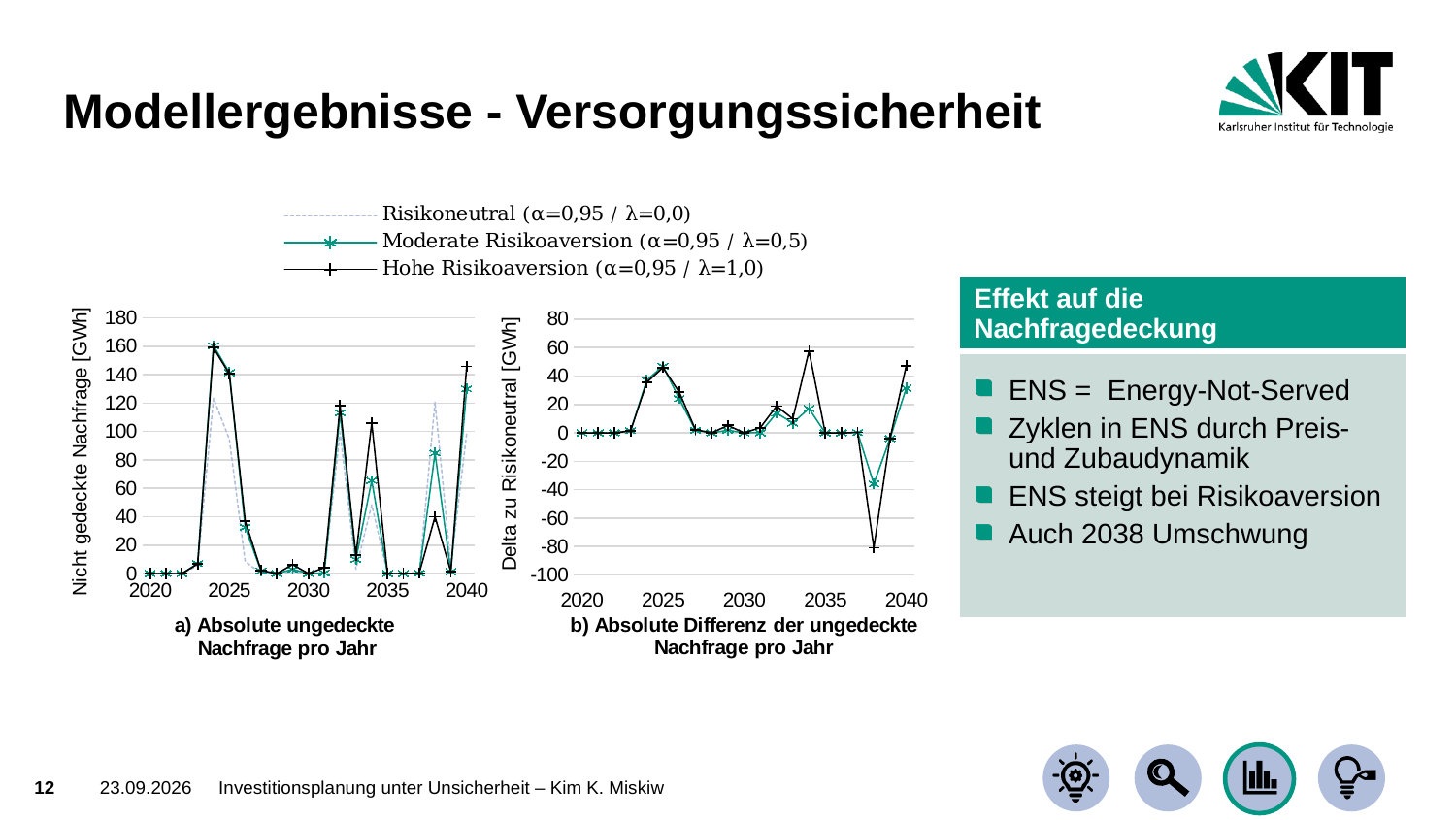
In chart b) "Absolute Differenz der ungedeckte Nachfrage pro Jahr", is the highest value of the Hohe Risikoaversion line greater or less than 40? greater What kind of chart is chart a) "Absolute ungedeckte Nachfrage pro Jahr"? line chart In chart a) "Absolute ungedeckte Nachfrage pro Jahr", is the value for Hohe Risikoaversion in 2020 greater or less than 20? less In chart a) "Absolute ungedeckte Nachfrage pro Jahr", which series has the larger value in 2038, Moderate Risikoaversion or Hohe Risikoaversion? Moderate Risikoaversion In chart b) "Absolute Differenz der ungedeckte Nachfrage pro Jahr", is the lowest value of the Hohe Risikoaversion line greater or less than -60? less How many series does the legend list for the charts on this slide? 3 In chart b) "Absolute Differenz der ungedeckte Nachfrage pro Jahr", which series reaches the highest value? Hohe Risikoaversion In chart b) "Absolute Differenz der ungedeckte Nachfrage pro Jahr", which series reaches the lowest value? Hohe Risikoaversion In chart b) "Absolute Differenz der ungedeckte Nachfrage pro Jahr", which series has the lower value in 2038, Moderate Risikoaversion or Hohe Risikoaversion? Hohe Risikoaversion What range of years does the x axis of chart a) cover? 2020 to 2040 What is the y-axis title of chart b) on the right? Delta zu Risikoneutral [GWh]